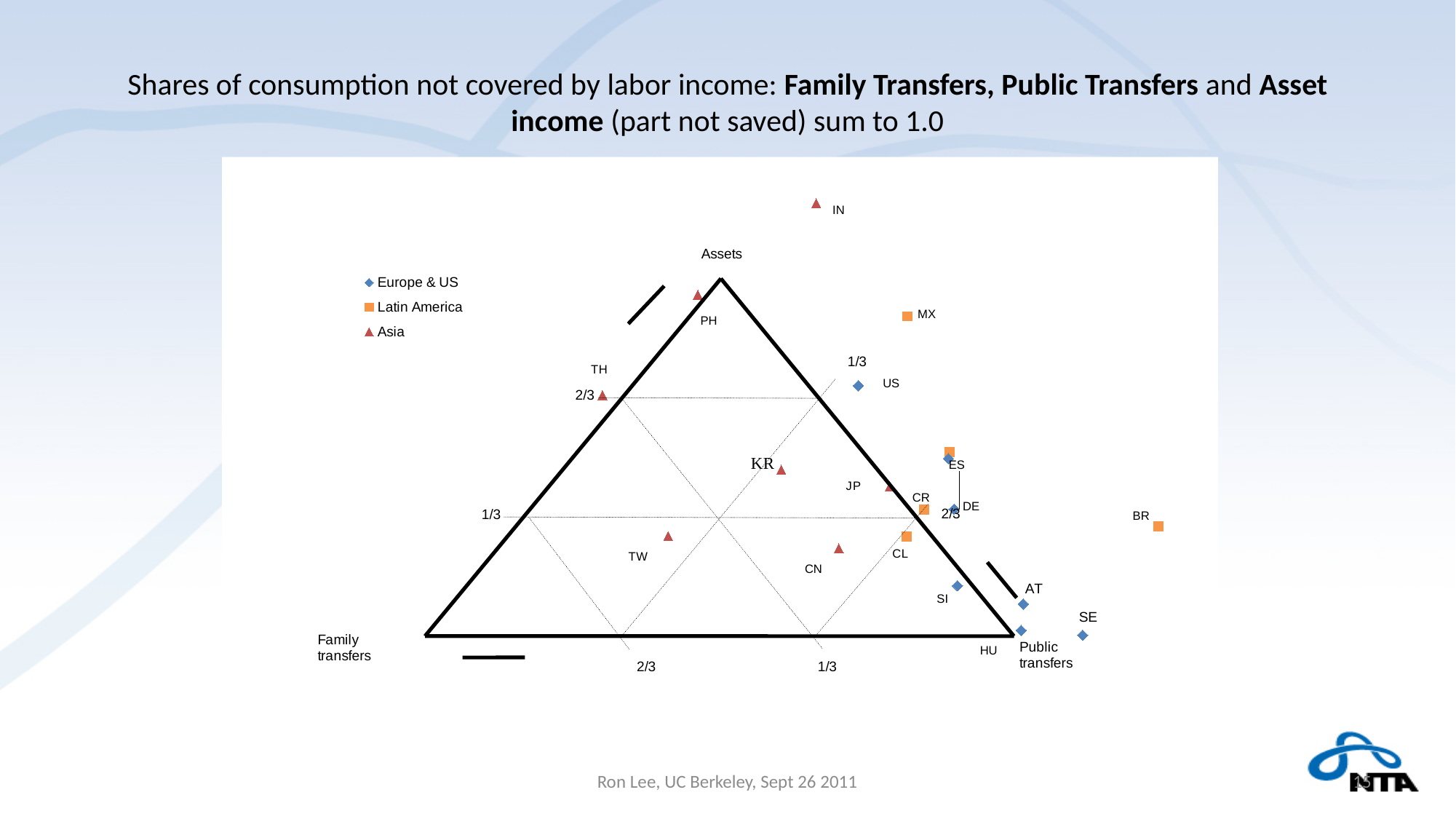
Which series does the point labeled MX belong to? Latin America Which series does the point labeled BR belong to? Latin America How many series does the legend list? 3 What are the three series named in the legend? Europe & US, Latin America, Asia What label is at the top corner of the triangle? Assets Which series does the point labeled US belong to? Europe & US Which labeled point is plotted farthest to the right? BR What kind of chart is shown on the slide? scatter chart Which point is plotted higher on the chart, IN or TH? IN Which labeled point is plotted highest on the chart? IN Which series does the point labeled SE belong to? Europe & US Which series does the point labeled IN belong to? Asia